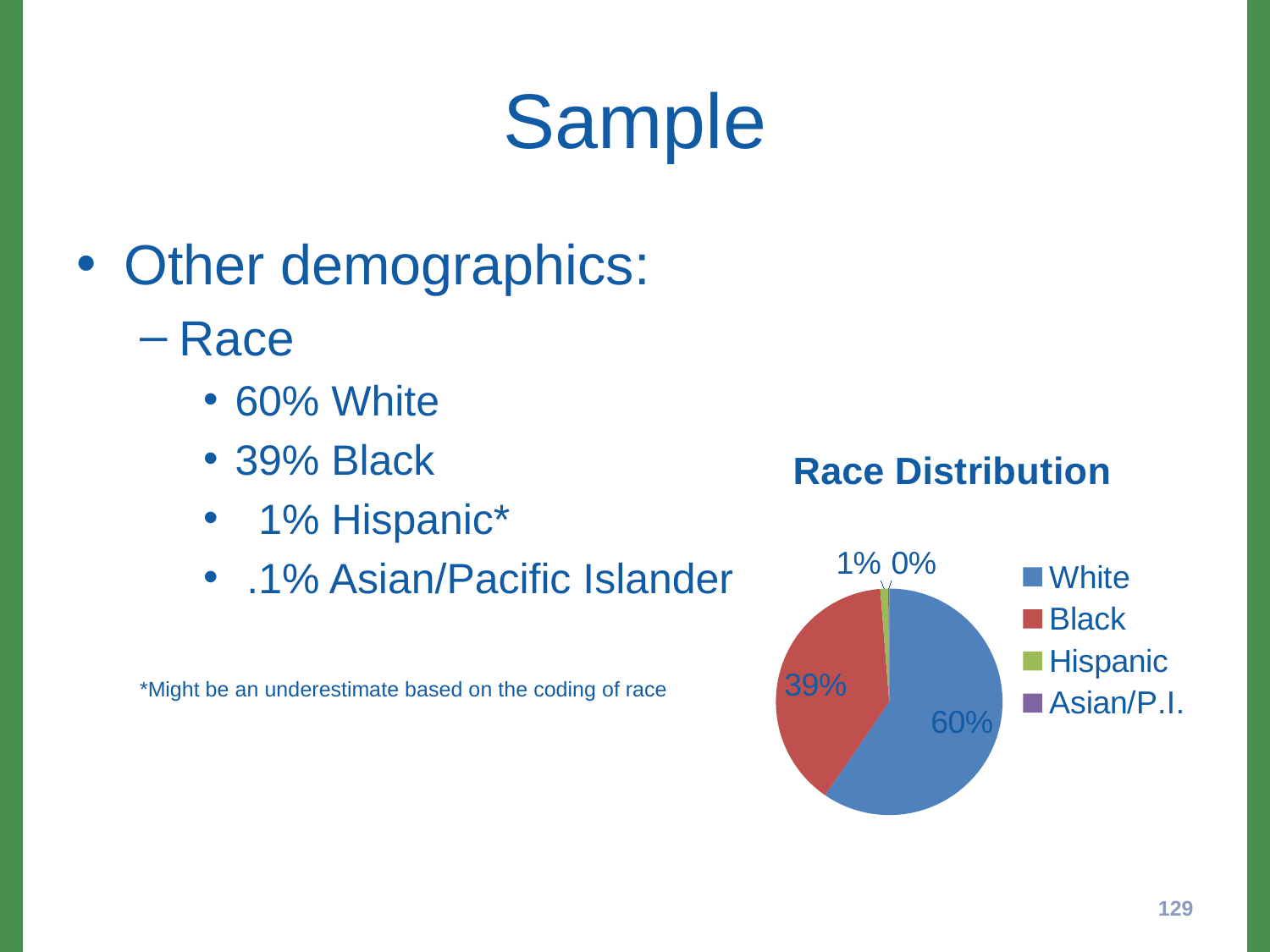
What share of the pie does White represent? 60% How many categories does the legend list? 4 What share of the pie does Black represent? 39% What colour is the Black slice in the pie chart? red Which category has the smallest slice of the pie? Asian/P.I. What share of the pie does Hispanic represent? 1% What kind of chart is shown on the slide? pie chart What is the difference between the White and Black shares? 21% Which is larger, the share for Black or the share for Hispanic? Black Which category has the largest slice of the pie? White What share of the pie does Asian/P.I. represent? 0% What is the title of the chart? Race Distribution